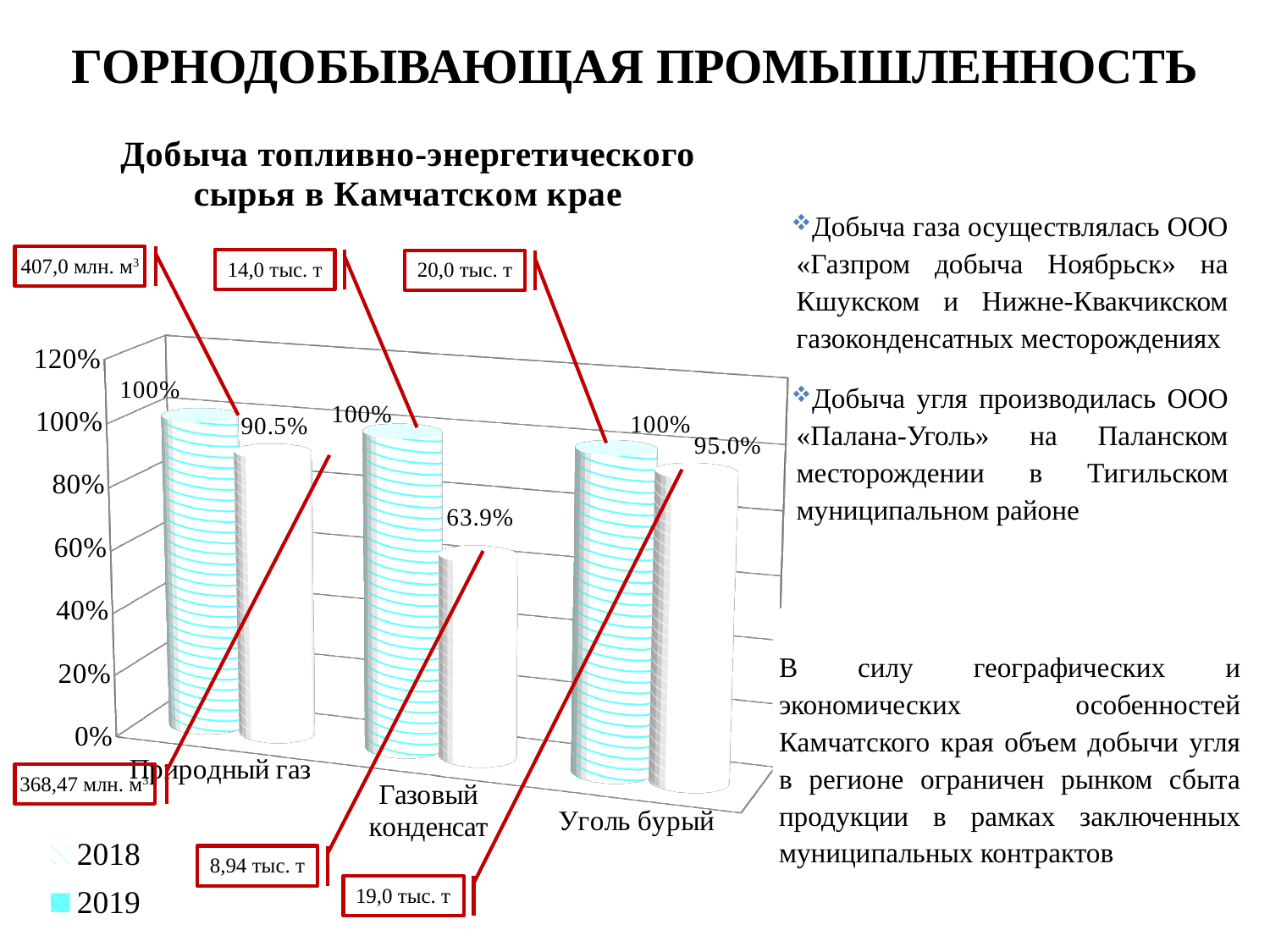
How many categories are shown on the x axis of the chart? 3 What is the 2019 value for Природный газ? 90.5% What is the 2019 value for Уголь бурый? 95.0% What type of chart is shown on the slide? bar chart What volume is annotated for the 2019 bar of Природный газ? 368,47 млн. м³ What is the 2019 value for Газовый конденсат? 63.9% Which category has the highest 2019 value? Уголь бурый Which category has the lowest 2019 value? Газовый конденсат Which is larger, the 2019 value for Природный газ or the 2019 value for Уголь бурый? Уголь бурый How many series does the chart legend list? 2 What is the title of the chart? Добыча топливно-энергетического сырья в Камчатском крае What is the difference between the 2018 and 2019 values for Газовый конденсат? 36.1%